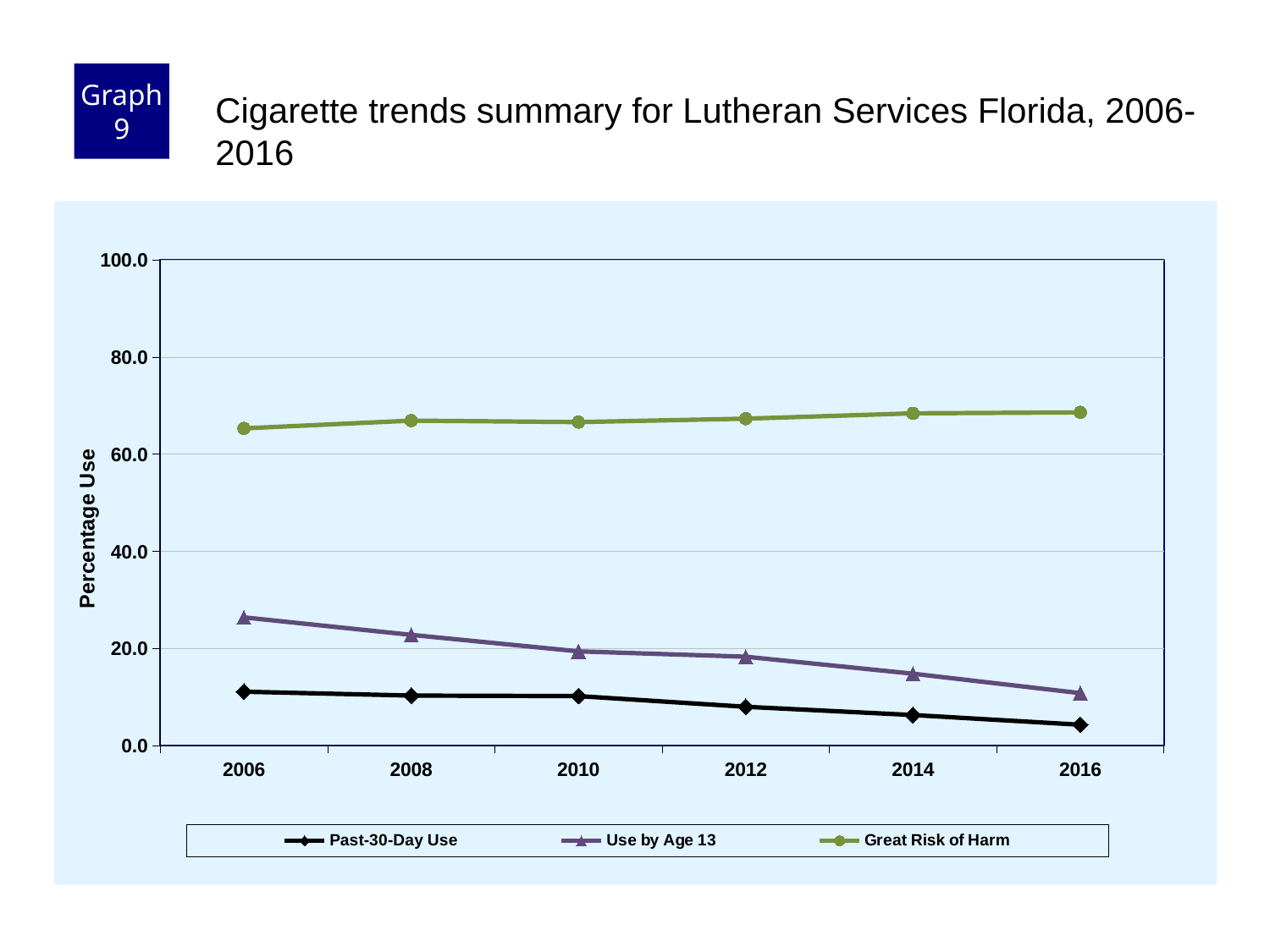
In 2010, which is larger: Use by Age 13 or Past-30-Day Use? Use by Age 13 Is the value for Great Risk of Harm in 2006 greater or less than 60? greater What kind of chart is shown on the slide? line chart How many series does the legend list? 3 Is the value for Use by Age 13 in 2016 greater or less than 20? less Is the value for Use by Age 13 in 2006 greater or less than 20? greater Does the Use by Age 13 series rise or fall from 2006 to 2016? fall In which year is the Use by Age 13 series highest? 2006 In which year is the Past-30-Day Use series lowest? 2016 Does the Past-30-Day Use series rise or fall from 2006 to 2016? fall How many years are plotted along the x axis? 6